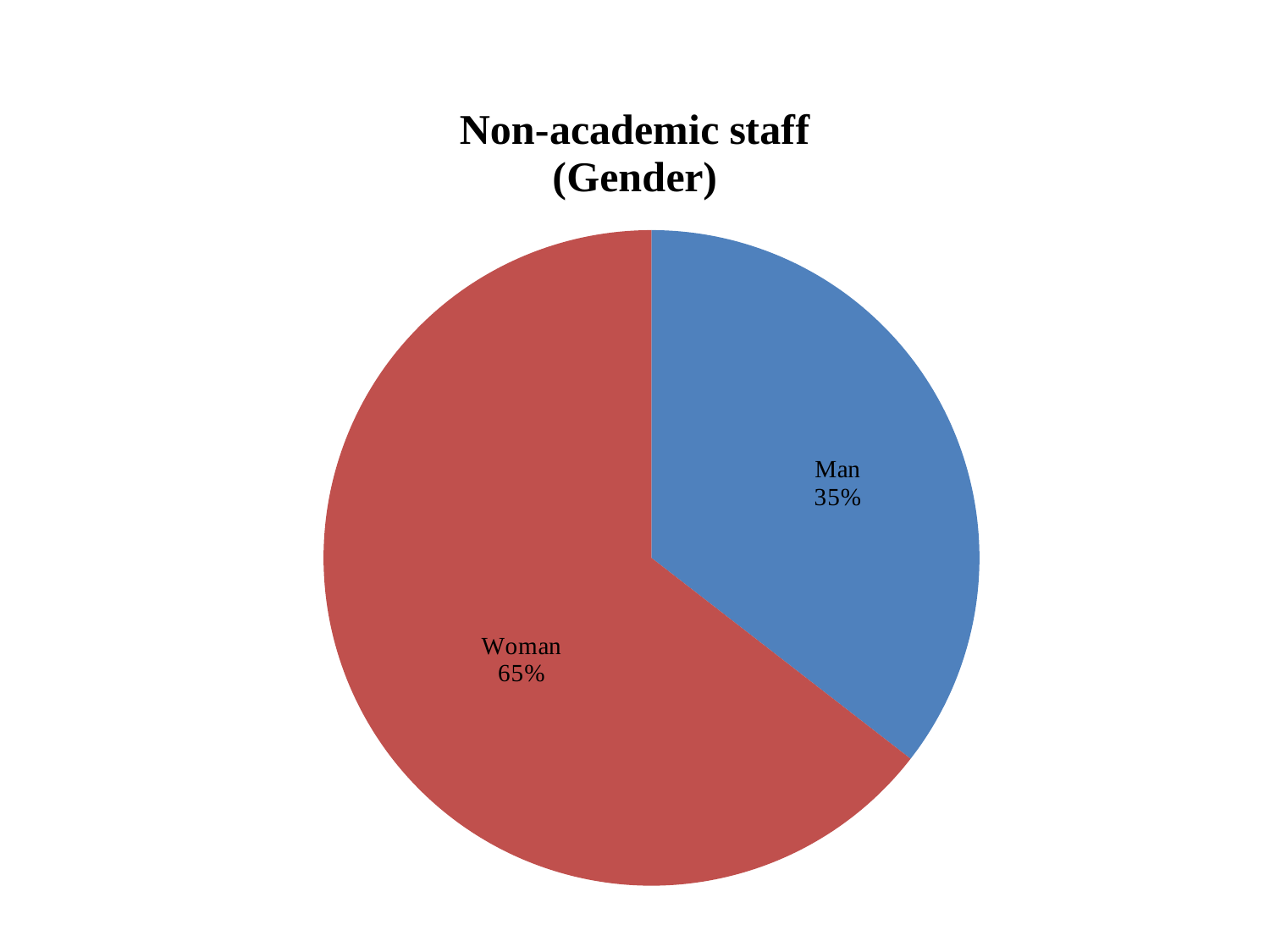
Which gender has the largest share of non-academic staff? Woman What share of the pie does the Man slice represent? 35% What is the title of the chart? Non-academic staff (Gender) What colour is the Woman slice? Red Which gender has the smallest share of non-academic staff? Man What percentage of non-academic staff are men? 35% What kind of chart is shown on the slide? Pie chart What is the difference in percentage points between the Woman and Man shares? 30 How many slices does the pie chart have? 2 Which is larger, the share for Man or the share for Woman? Woman What percentage of non-academic staff are women? 65%